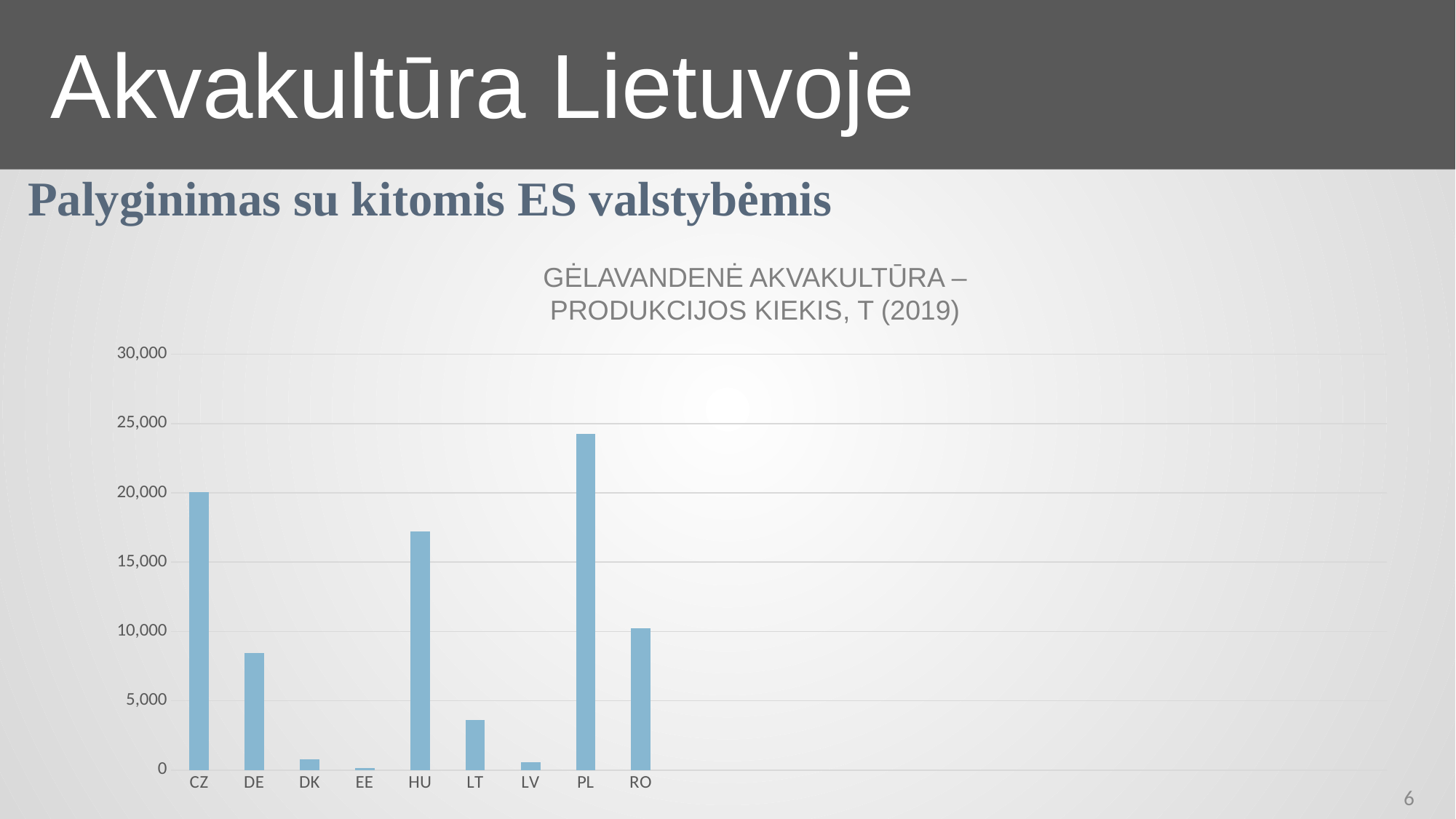
Is the value for DE greater or less than 10,000? less Which has a larger value, DE or RO? RO How many countries are shown on the x axis of the chart? 9 What kind of chart is shown on the slide? bar chart Is the value for LT greater or less than 5,000? less Which country has the lowest freshwater aquaculture production in the chart? EE Which has a larger value, CZ or HU? CZ What is the title of the chart? GĖLAVANDENĖ AKVAKULTŪRA – PRODUKCIJOS KIEKIS, T (2019) Is the value for HU greater or less than 15,000? greater Which year does the chart's data refer to, according to its title? 2019 Which country has the highest freshwater aquaculture production in the chart? PL